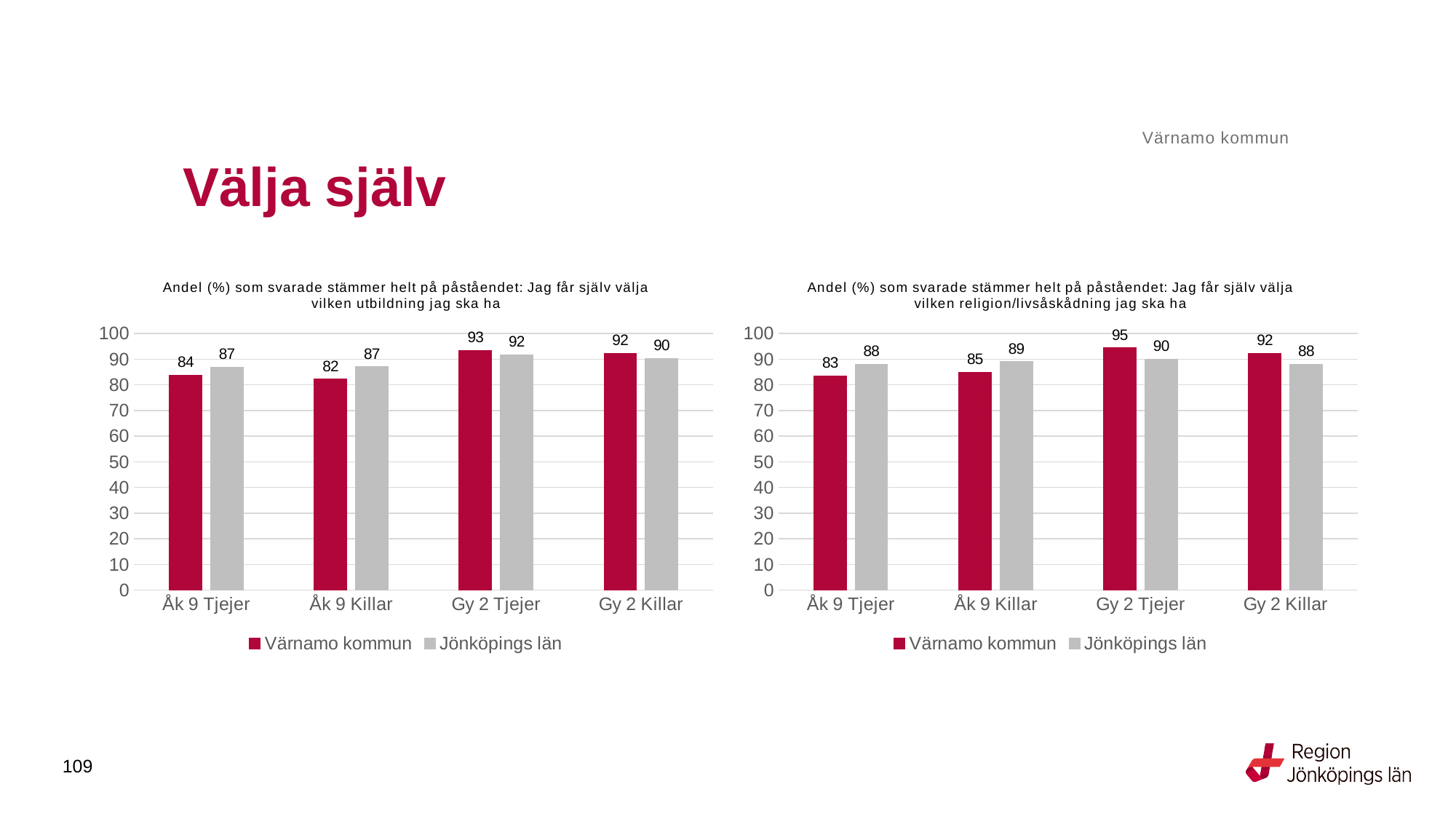
What kind of chart is the left chart (about choosing education)? Bar chart In the right chart (about choosing religion/livsåskådning), what is the value for Jönköpings län for Åk 9 Killar? 89 In the left chart (about choosing education), what is the value for Värnamo kommun for Åk 9 Tjejer? 84 How many categories are shown on the x axis of the left chart (about choosing education)? 4 How many series does the legend of the right chart (about choosing religion/livsåskådning) list? 2 In the left chart (about choosing education), which category has the highest value for Värnamo kommun? Gy 2 Tjejer In the right chart (about choosing religion/livsåskådning), what is the difference between Jönköpings län and Värnamo kommun for Åk 9 Tjejer? 5 In the right chart (about choosing religion/livsåskådning), what colour are the bars for Värnamo kommun? Red In the right chart (about choosing religion/livsåskådning), which category has the lowest value for Värnamo kommun? Åk 9 Tjejer In the left chart (about choosing education), is the value for Värnamo kommun for Åk 9 Killar greater or less than 90? less In the left chart (about choosing education), which is larger for Åk 9 Killar: Värnamo kommun or Jönköpings län? Jönköpings län In the right chart (about choosing religion/livsåskådning), which is larger for Gy 2 Tjejer: Värnamo kommun or Jönköpings län? Värnamo kommun